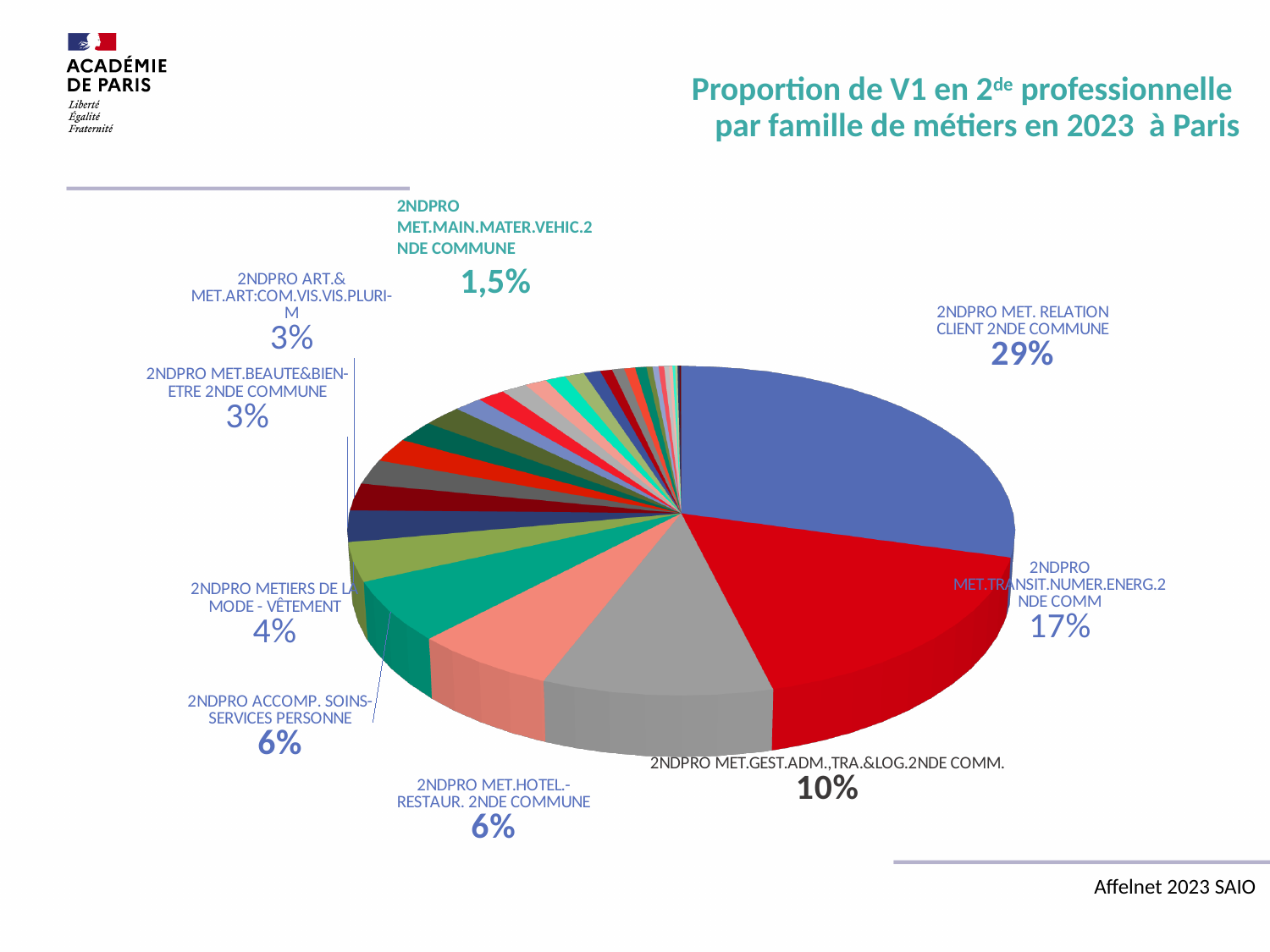
Which family of trades has the largest share of the pie? 2NDPRO MET. RELATION CLIENT 2NDE COMMUNE What is the value shown for 2NDPRO MET.TRANSIT.NUMER.ENERG.2NDE COMM? 17% What is the value shown for 2NDPRO MET.GEST.ADM.,TRA.&LOG.2NDE COMM.? 10% What is the value shown for 2NDPRO MET.MAIN.MATER.VEHIC.2NDE COMMUNE? 1,5% Which is larger: the share of 2NDPRO ACCOMP. SOINS-SERVICES PERSONNE or the share of 2NDPRO METIERS DE LA MODE - VÊTEMENT? 2NDPRO ACCOMP. SOINS-SERVICES PERSONNE What is the difference between the shares of 2NDPRO MET. RELATION CLIENT 2NDE COMMUNE and 2NDPRO MET.TRANSIT.NUMER.ENERG.2NDE COMM? 12% What is the title of the chart? Proportion de V1 en 2de professionnelle par famille de métiers en 2023 à Paris What share of the pie does 2NDPRO MET. RELATION CLIENT 2NDE COMMUNE represent? 29% What is the value shown for 2NDPRO METIERS DE LA MODE - VÊTEMENT? 4% What is the value shown for 2NDPRO MET.HOTEL.-RESTAUR. 2NDE COMMUNE? 6% What is the difference between the shares of 2NDPRO MET.BEAUTE&BIEN-ETRE 2NDE COMMUNE and 2NDPRO MET.MAIN.MATER.VEHIC.2NDE COMMUNE? 1,5% What type of chart is shown on the slide? Pie chart